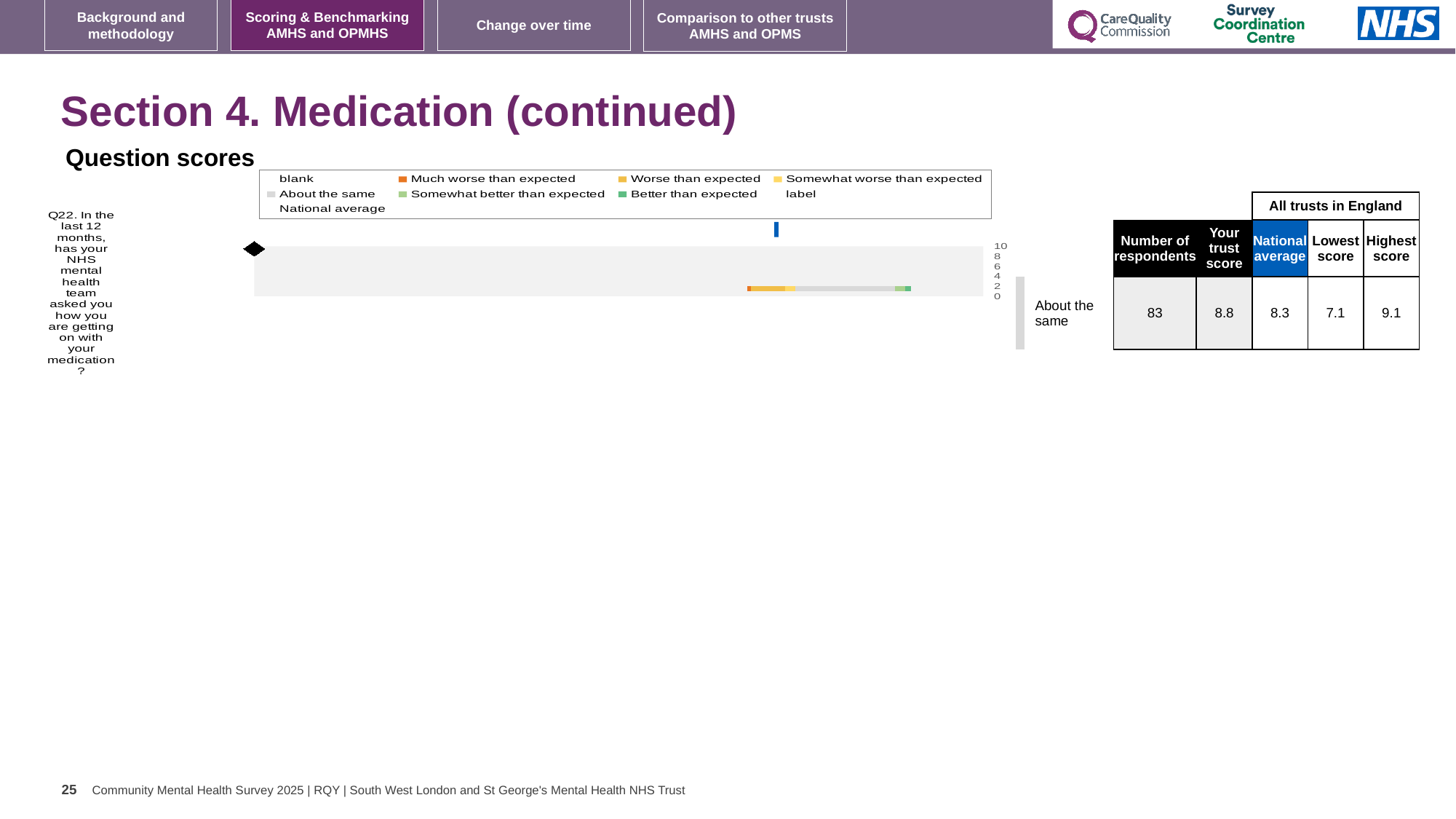
What is the highest tick value shown on the axis of the 'Question scores' chart? 10 What kind of chart is shown under 'Question scores'? bar chart In the table beside the chart, what is the lowest score among all trusts in England for Q22? 7.1 How many survey questions are plotted in the 'Question scores' chart? 1 In the table beside the chart, what is the number of respondents for Q22? 83 In the table beside the chart, what is the trust's score for Q22? 8.8 In the table beside the chart, what is the highest score among all trusts in England for Q22? 9.1 In the table beside the chart, what is the national average score for Q22? 8.3 Is the trust's score for Q22 higher or lower than the national average? higher Which legend entry in the 'Question scores' chart is shown in orange? Much worse than expected What is the difference between the trust's score and the national average for Q22? 0.5 What benchmark category is given for Q22 next to the chart? About the same